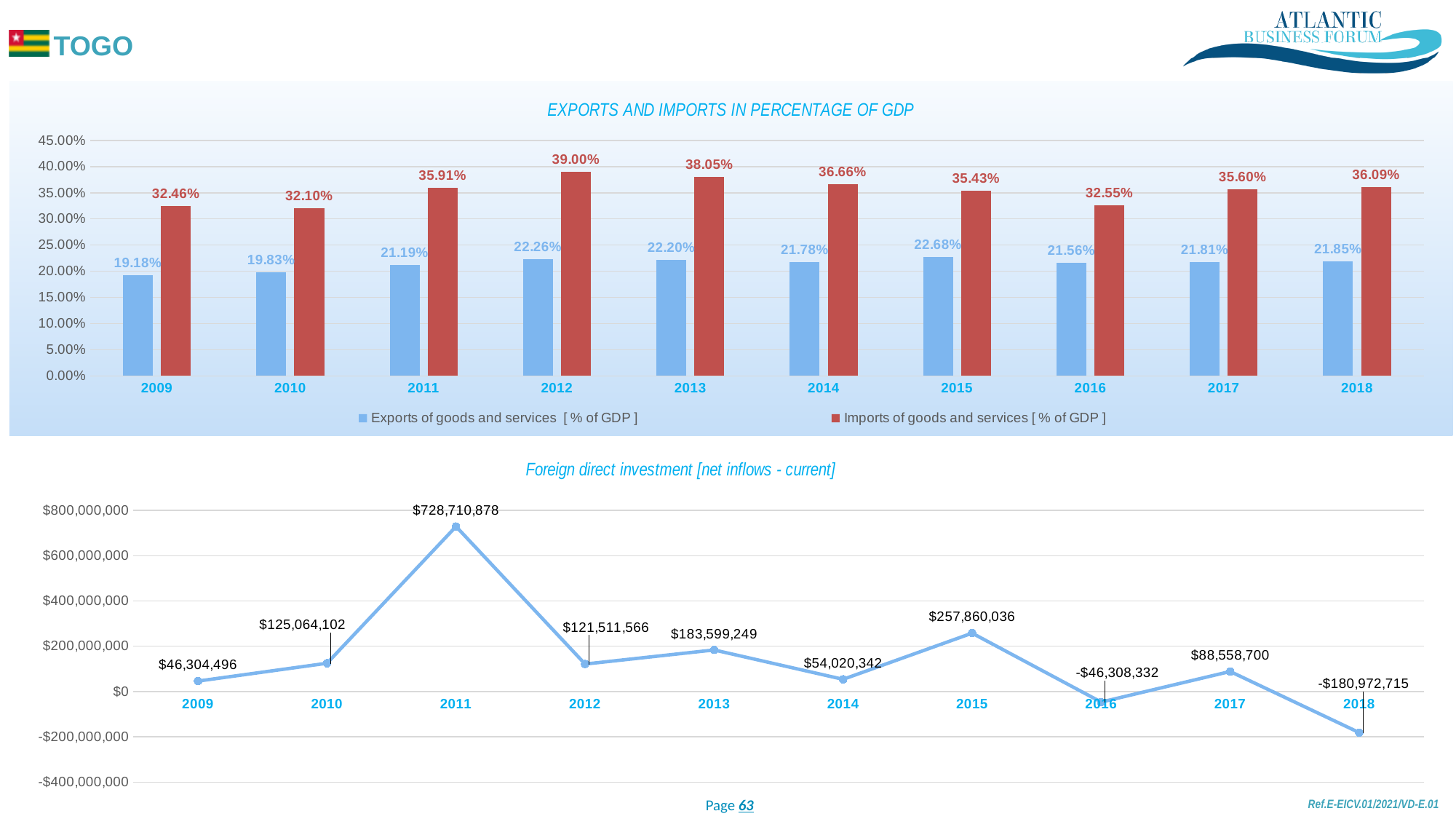
What kind of chart is the 'Exports and Imports in Percentage of GDP' chart? Bar chart In the 'Exports and Imports in Percentage of GDP' chart, what is the value of Imports of goods and services in 2012? 39.00% In the 'Foreign direct investment' chart, which is larger, the value for 2013 or the value for 2014? 2013 What kind of chart is the 'Foreign direct investment' chart? Line chart In the 'Exports and Imports in Percentage of GDP' chart, which year has the highest Exports of goods and services value? 2015 In the 'Foreign direct investment' chart, how many years are plotted? 10 In the 'Exports and Imports in Percentage of GDP' chart, how many series does the legend list? 2 In the 'Foreign direct investment' chart, what is the value for 2011? $728,710,878 In the 'Foreign direct investment' chart, which year has the lowest value? 2018 In the 'Exports and Imports in Percentage of GDP' chart, what is the value of Exports of goods and services in 2009? 19.18% In the 'Exports and Imports in Percentage of GDP' chart, which year has the lowest Imports of goods and services value? 2010 In the 'Exports and Imports in Percentage of GDP' chart, what is the difference between Imports and Exports in 2018? 14.24%